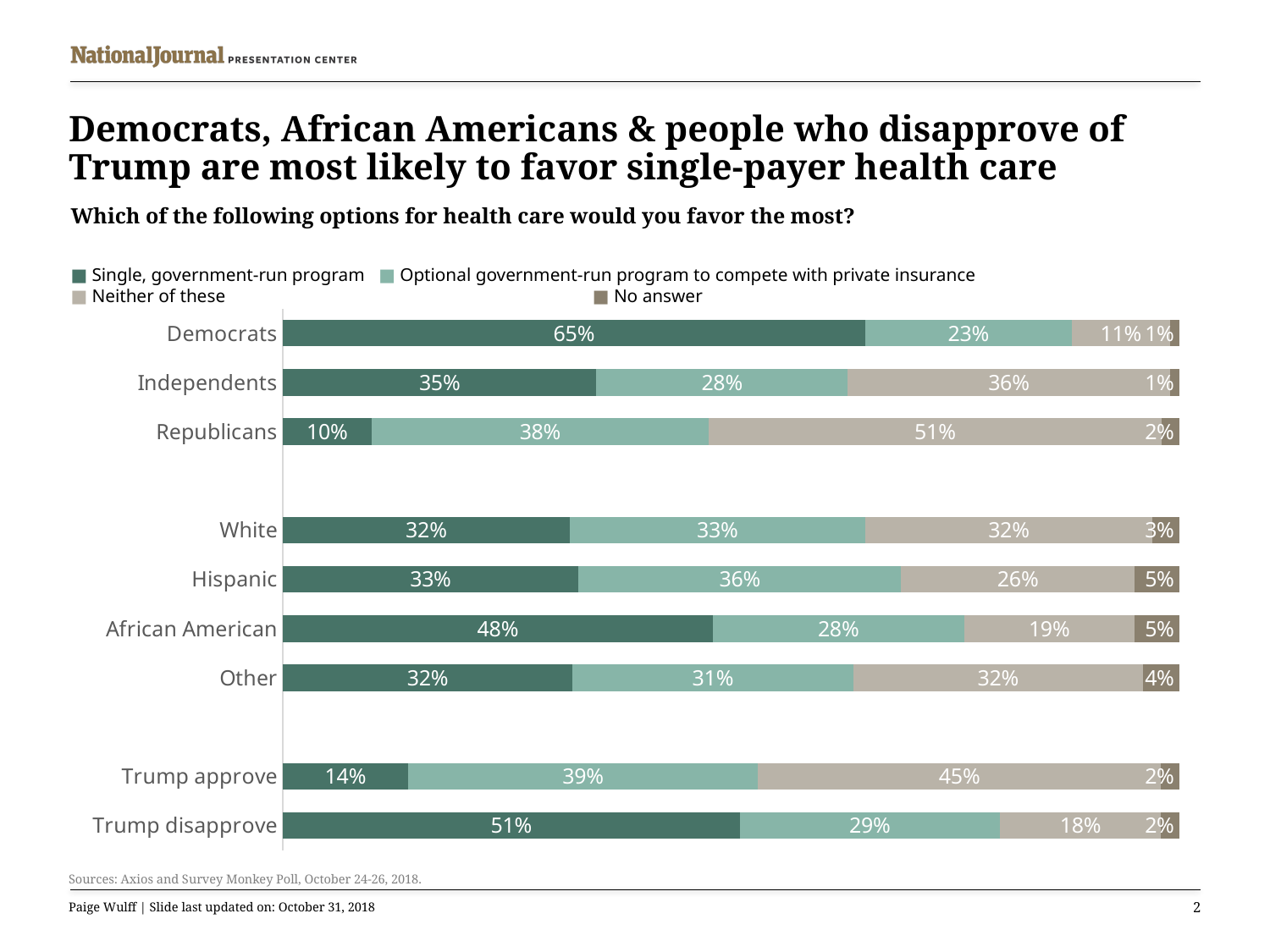
What percentage of Republicans chose "Neither of these"? 51% What percentage of Democrats favor a single, government-run program? 65% What percentage of Hispanic respondents favor an optional government-run program to compete with private insurance? 36% Who has a larger share favoring a single, government-run program: people who approve of Trump or people who disapprove of Trump? Trump disapprove What is the difference in percentage points between Democrats and Republicans favoring a single, government-run program? 55 percentage points Which group has the highest share favoring a single, government-run program? Democrats How many groups (categories) are shown in the chart? 9 Which group has the lowest share favoring a single, government-run program? Republicans What is the total of the labeled segments in the Republicans bar? 101% What kind of chart is shown on the slide? Stacked bar chart How many series does the legend list? 4 What percentage of African American respondents gave no answer? 5%